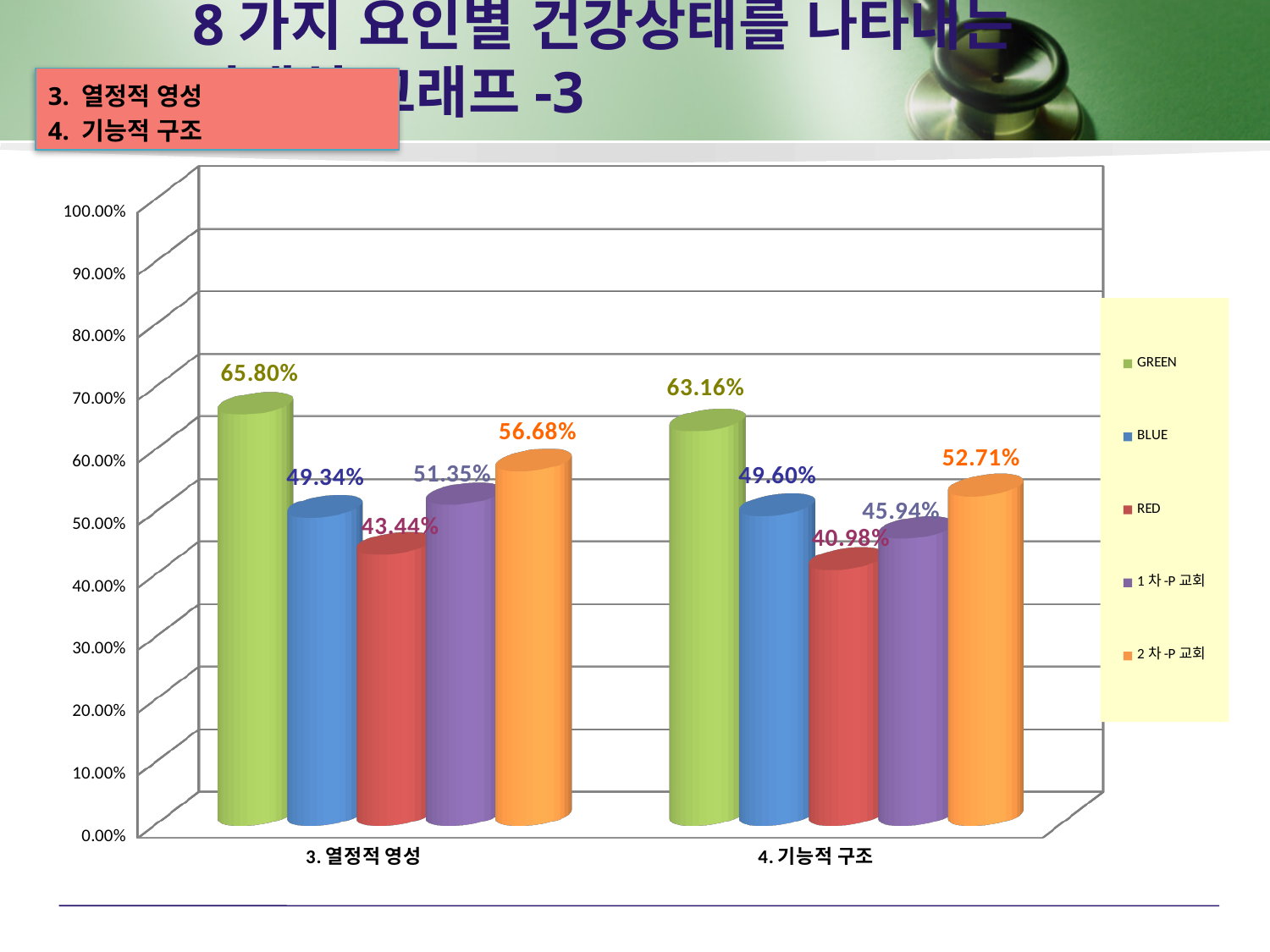
Which series has the highest value in the category 4. 기능적 구조? GREEN What is the value for 1 차-P 교회 in the category 4. 기능적 구조? 45.94% Which series has the lowest value in the category 3. 열정적 영성? RED How many categories are shown on the x axis? 2 Which is larger: the BLUE value for 3. 열정적 영성 or the BLUE value for 4. 기능적 구조? 4. 기능적 구조 What is the value for 2 차-P 교회 in the category 3. 열정적 영성? 56.68% What is the value for GREEN in the category 3. 열정적 영성? 65.80% Is the value for 2 차-P 교회 in 4. 기능적 구조 greater or less than 60.00%? less How many series does the legend list? 5 What kind of chart is shown on the slide? bar chart What is the value for RED in the category 4. 기능적 구조? 40.98% What is the difference between the GREEN values for 3. 열정적 영성 and 4. 기능적 구조? 2.64%